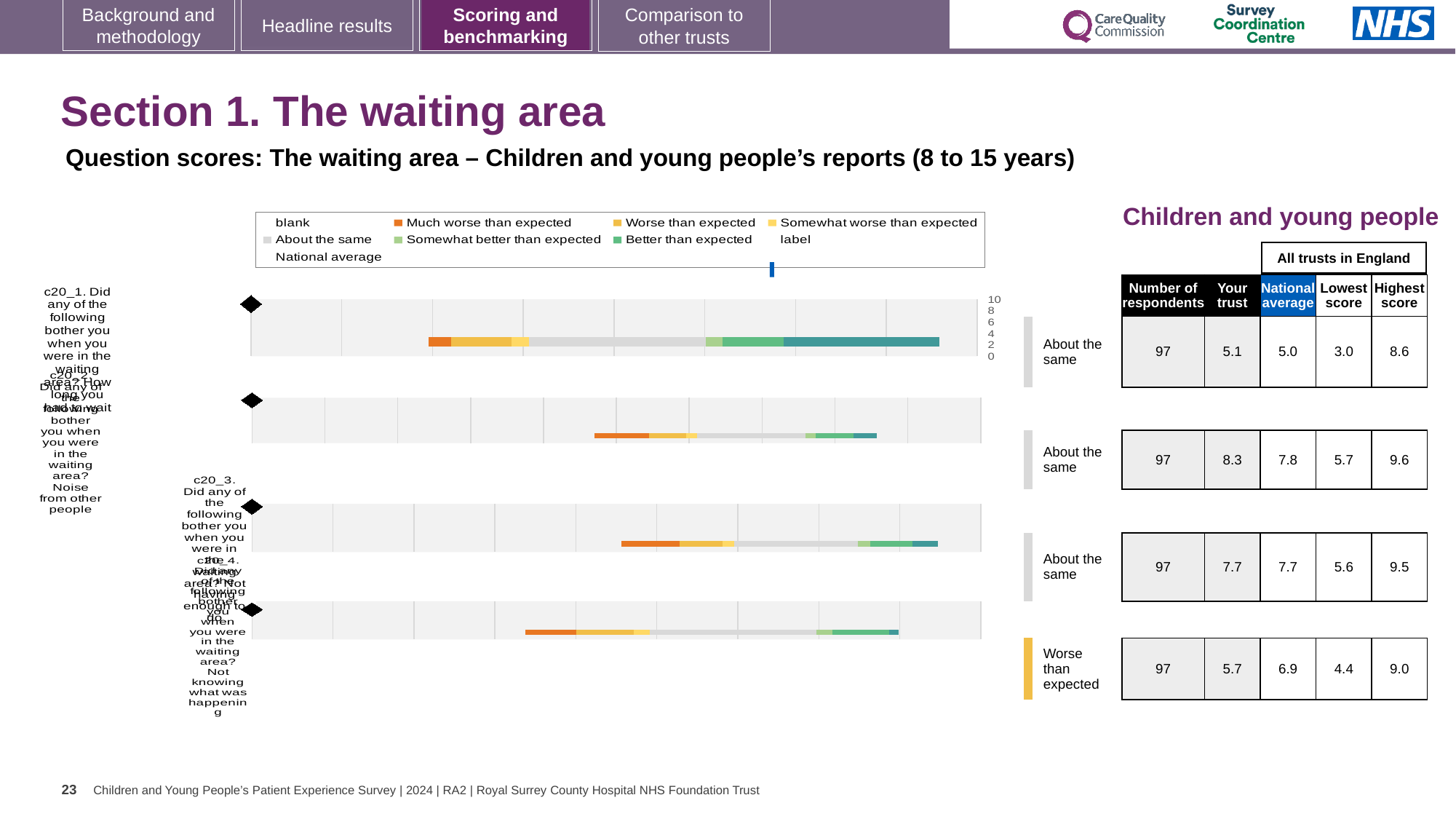
What is the national average for the second question row (c20_2, how long you had to wait)? 7.8 Which question row has the lowest 'Your trust' score? c20_1 (noise from other people), 5.1 What is the highest score across all trusts in England for the third question row (c20_3, not having enough to do)? 9.5 What is the 'Your trust' score for the first question row (c20_1, noise from other people)? 5.1 In the legend, which colour represents 'Much worse than expected'? Orange What kind of chart is used to show the question scores for the waiting area? Bar chart How many separate bar charts (question rows) are plotted on the slide? 4 How many entries does the chart legend list? 9 Which question row has the highest 'Your trust' score? c20_2 (how long you had to wait), 8.3 What is the difference between the 'Your trust' score and the national average for the second question row (c20_2)? 0.5 What is the lowest score across all trusts in England for the fourth question row (c20_4, not knowing what was happening)? 4.4 For the fourth question row (c20_4), is the 'Your trust' score or the national average larger? National average (6.9)